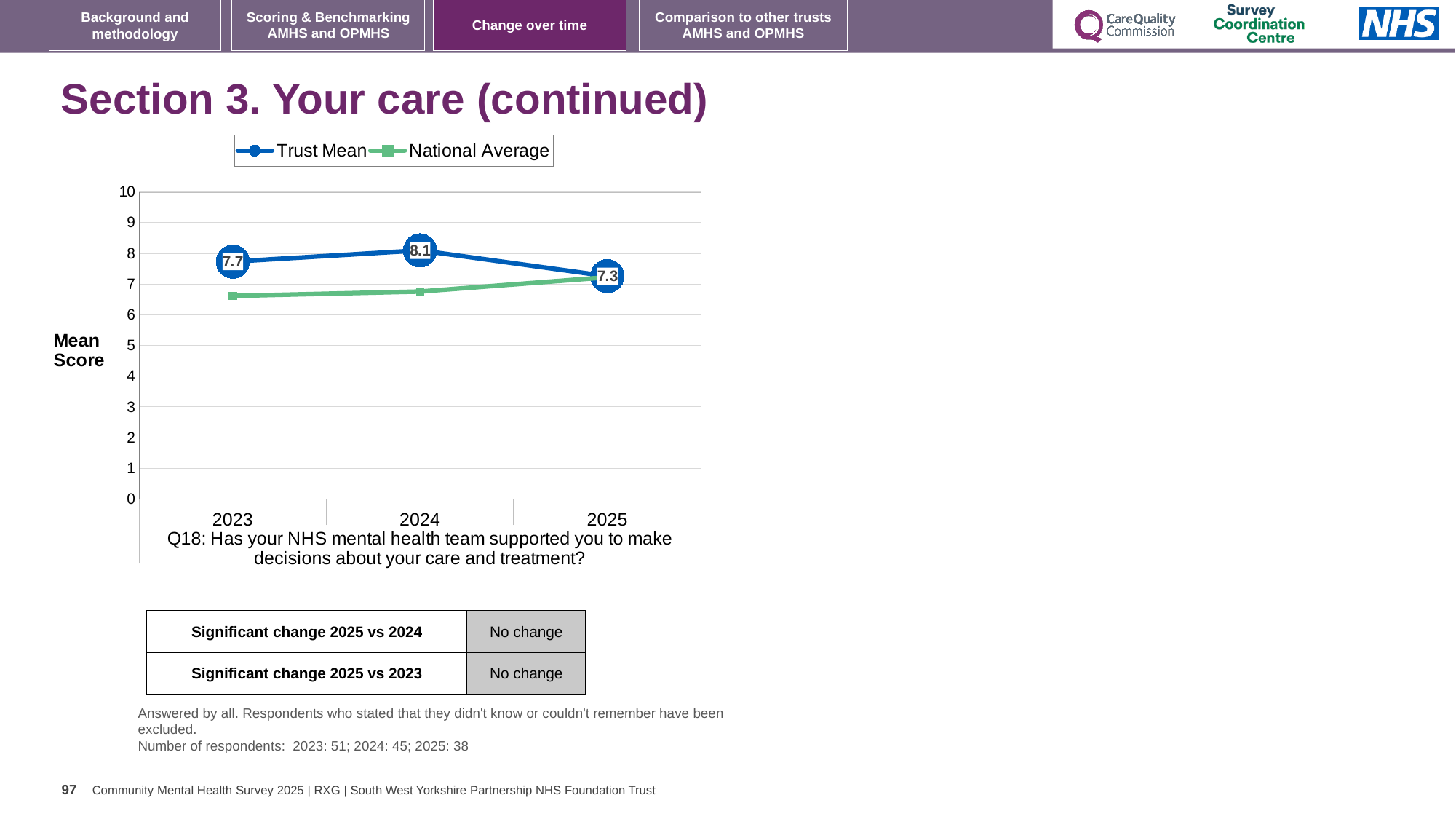
Is the National Average for 2023 greater or less than 7? less By how much did the Trust Mean change from 2024 to 2025? 0.8 How many series does the legend list? 2 In which year is the Trust Mean highest? 2024 What is the Trust Mean score for 2024? 8.1 How many years are shown on the x axis? 3 What is the Trust Mean score for 2023? 7.7 What is the difference between the Trust Mean in 2024 and in 2023? 0.4 What kind of chart is shown on the slide? Line chart What is the Trust Mean score for 2025? 7.3 Which is larger in 2023, the Trust Mean or the National Average? Trust Mean In which year is the Trust Mean lowest? 2025